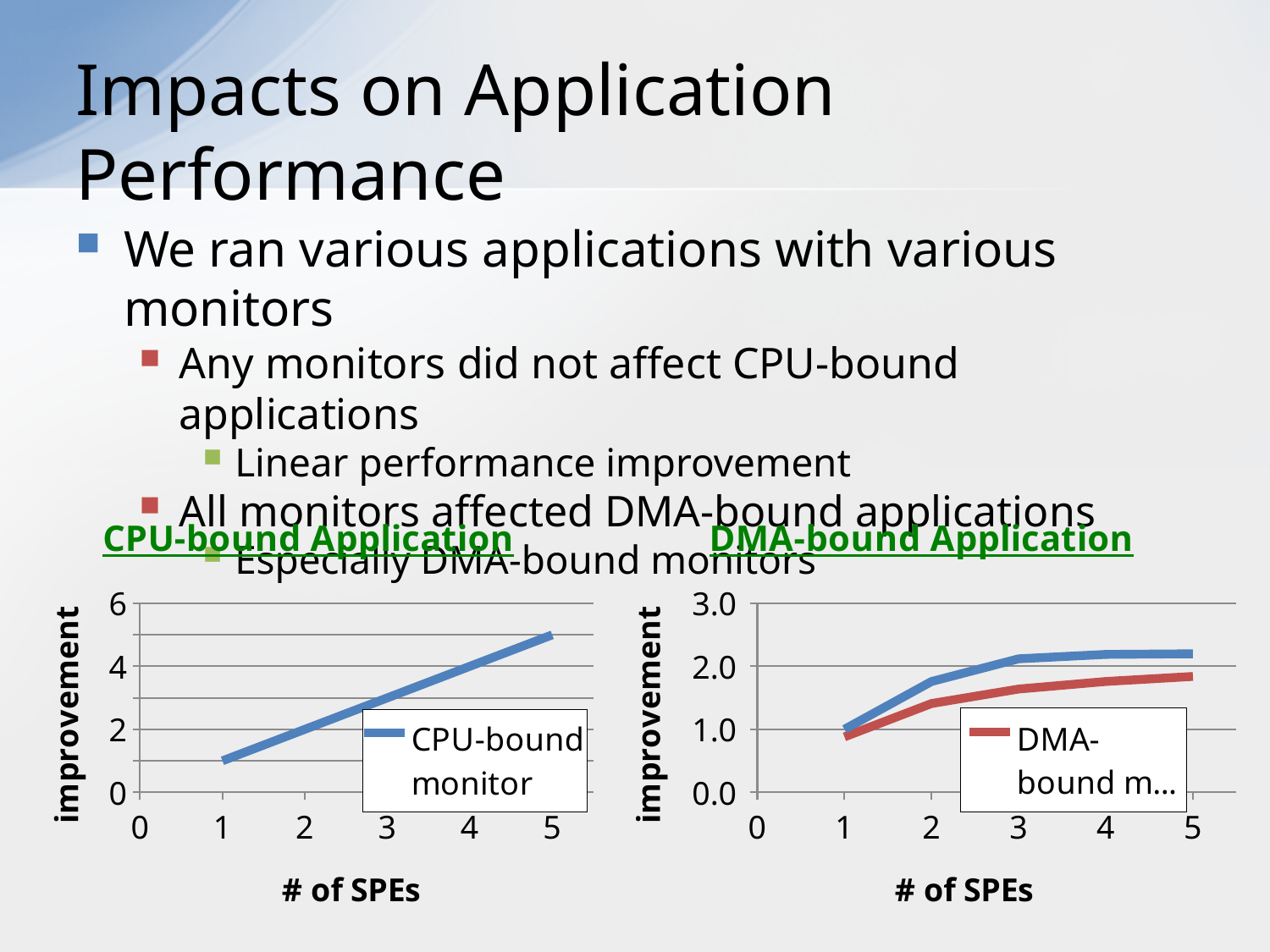
What kind of chart is the DMA-bound Application chart on the right? line chart What kind of chart is the CPU-bound Application chart on the left? line chart In the CPU-bound Application chart, does the improvement rise or fall as the number of SPEs increases? rise How many lines are plotted in the DMA-bound Application chart? 2 How many series does the legend of the CPU-bound Application chart list? 1 What is the x-axis title of the CPU-bound Application chart? # of SPEs In the CPU-bound Application chart, is the improvement at 5 SPEs greater or less than 4? greater In the DMA-bound Application chart, is the red line's improvement at 5 SPEs greater or less than 2.0? less In the DMA-bound Application chart, is the blue line's improvement at 5 SPEs greater or less than 2.0? greater In the DMA-bound Application chart, does the blue line rise or fall as the number of SPEs increases? rise In the DMA-bound Application chart, which line shows the higher improvement at 5 SPEs, the blue line or the red line? the blue line